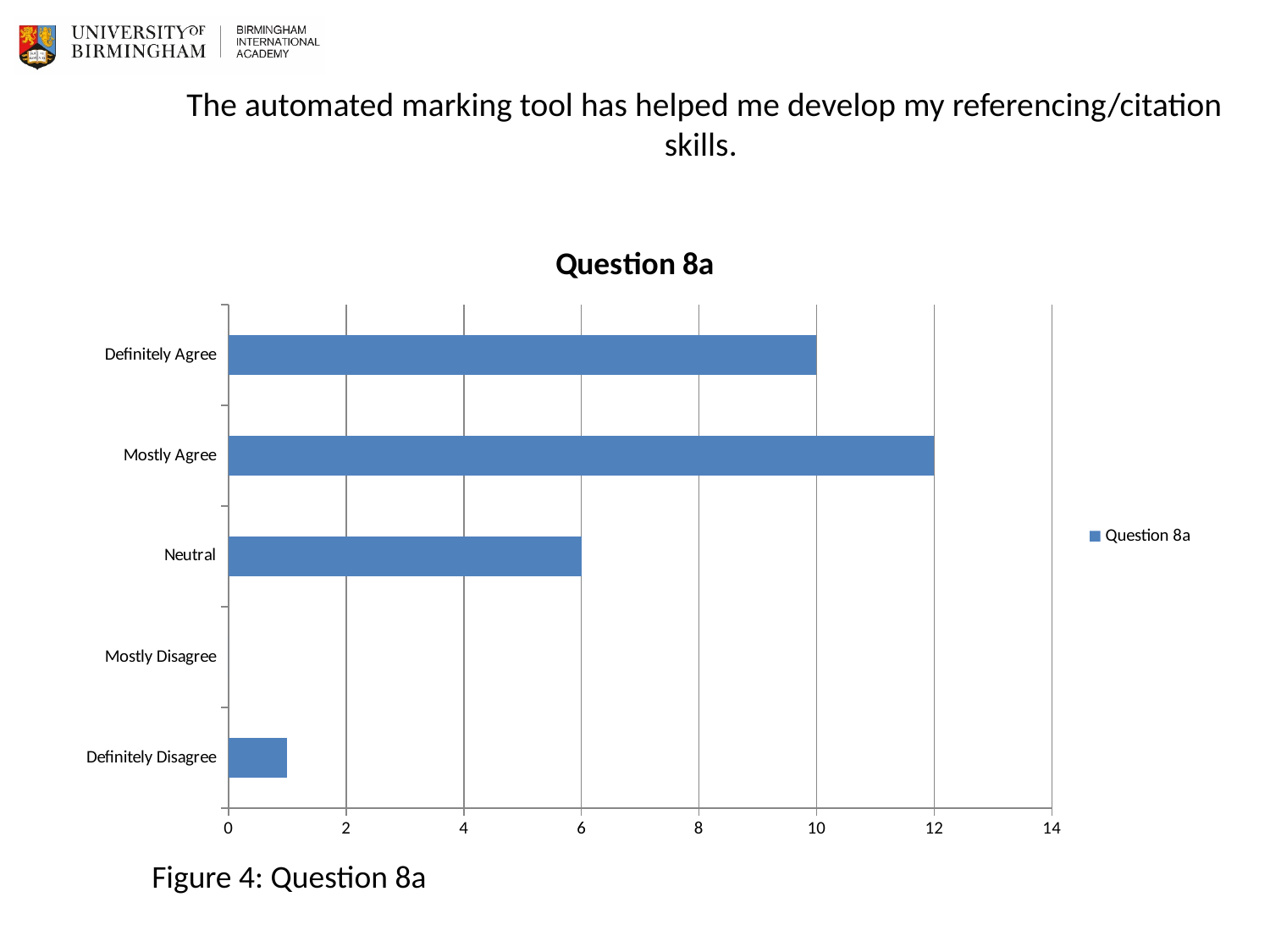
Is the value for Definitely Disagree greater or less than 2? less What kind of chart is shown on the slide? bar chart What is the difference between the values for Definitely Agree and Neutral? 4 What is the value for Mostly Agree? 12 How many categories are shown on the chart? 5 Which is larger, the value for Neutral or the value for Definitely Agree? Definitely Agree Which category has the highest value? Mostly Agree What is the value for Neutral? 6 What is the value for Definitely Agree? 10 What is the difference between the values for Mostly Agree and Definitely Agree? 2 How many series does the legend list? 1 Which category has the lowest value? Mostly Disagree